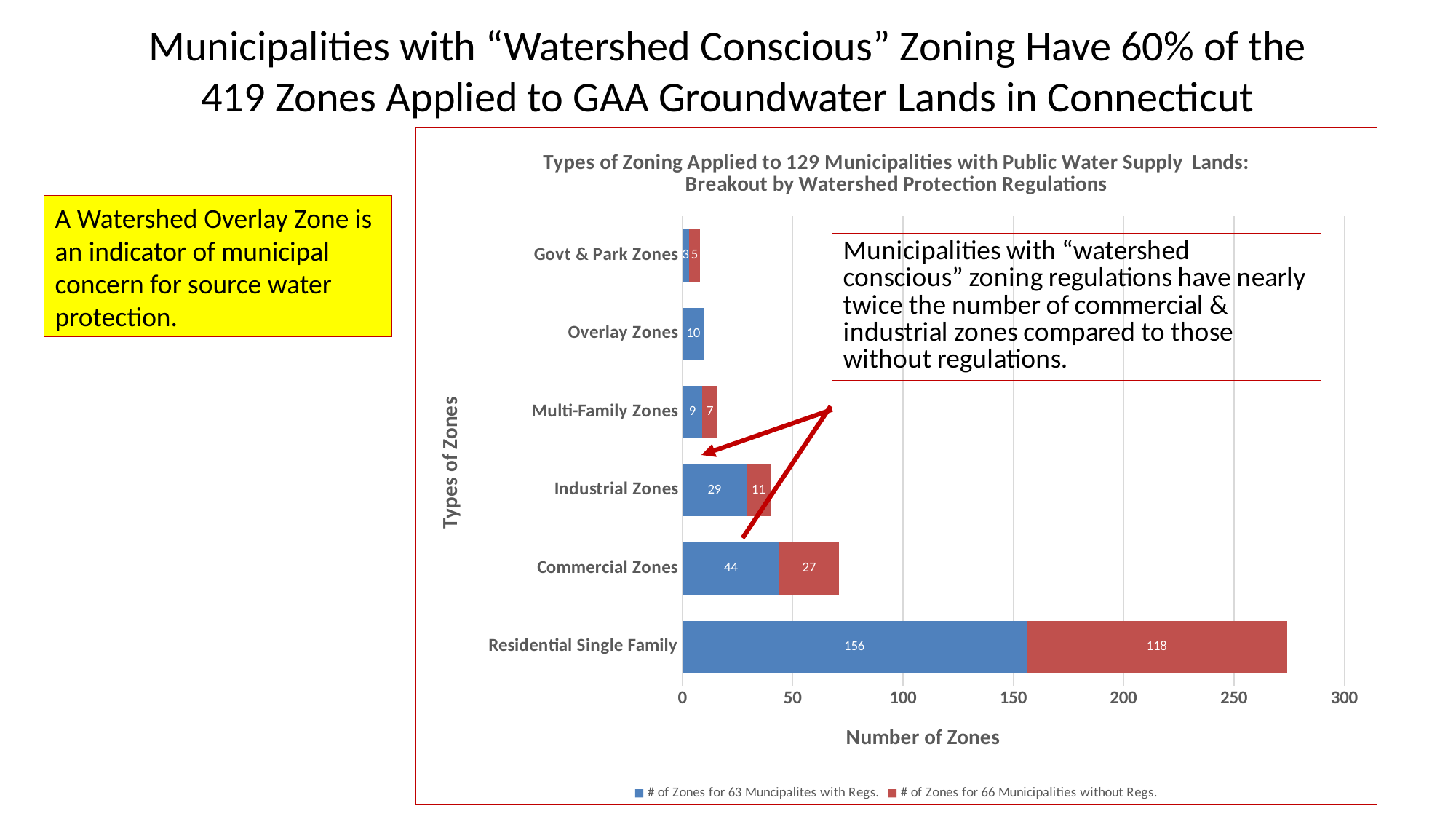
What kind of chart is shown on the slide? Stacked bar chart What is the title of the chart's x axis? Number of Zones What is the total number of Commercial Zones across both series? 71 Which is larger: Multi-Family Zones with regulations or Multi-Family Zones without regulations? Multi-Family Zones with regulations How many series does the legend list? 2 What is the number of Industrial Zones for the 63 municipalities with regulations? 29 What is the total number of Residential Single Family zones across both series? 274 What is the number of Commercial Zones for the 63 municipalities with regulations? 44 Which zone type has the highest total number of zones? Residential Single Family What is the difference between Industrial Zones with regulations and Industrial Zones without regulations? 18 What is the number of Residential Single Family zones for the 66 municipalities without regulations? 118 How many zone types (categories) are shown on the chart? 6